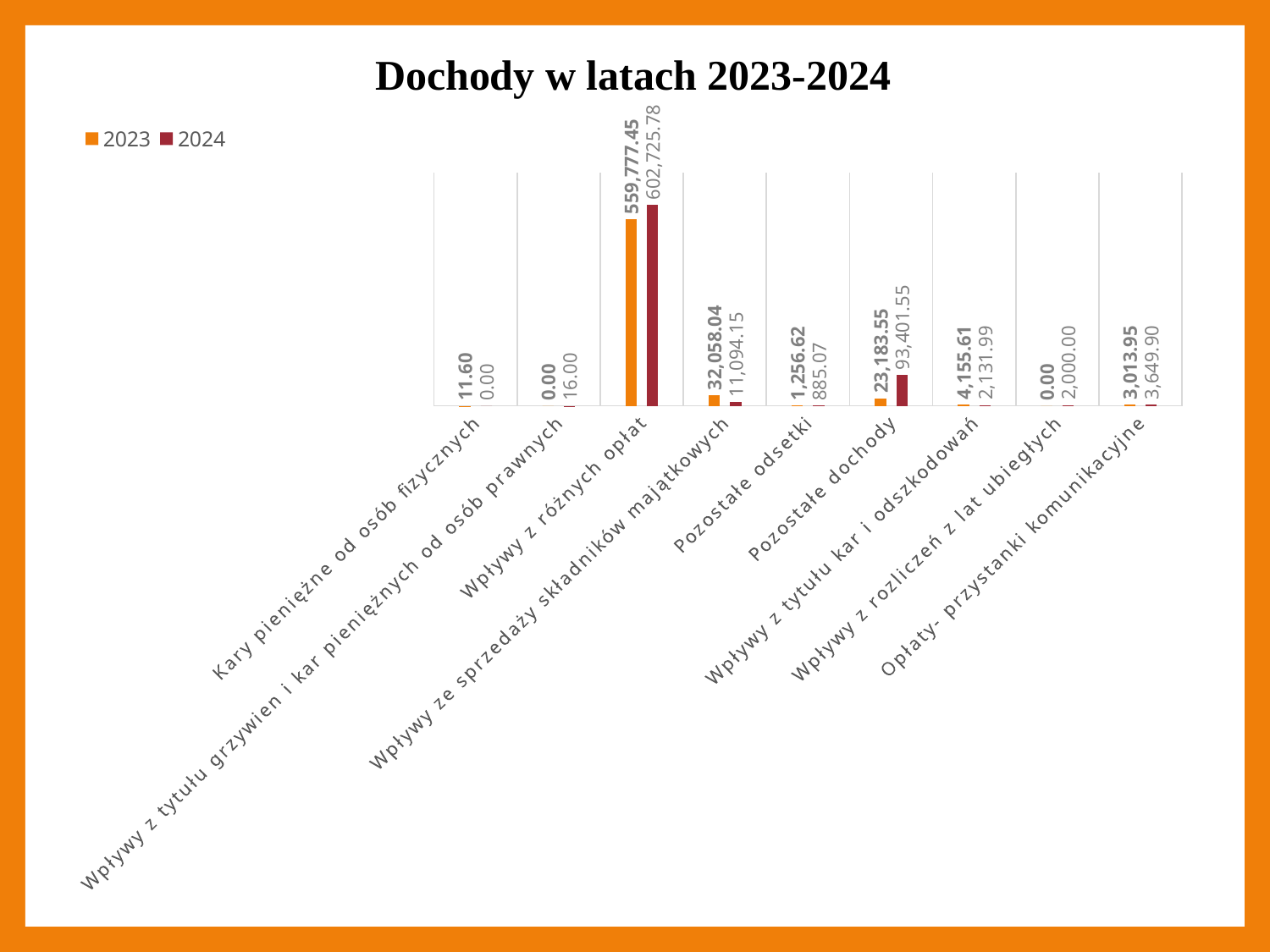
How many series does the legend list? 2 What is the difference between the 2024 and 2023 values for Wpływy z różnych opłat? 42,948.33 What is the 2024 value for Wpływy ze sprzedaży składników majątkowych? 11,094.15 Which is larger for Pozostałe odsetki, the 2023 value or the 2024 value? 2023 What is the 2023 value for Opłaty- przystanki komunikacyjne? 3,013.95 Which category has the highest 2024 value? Wpływy z różnych opłat What is the difference between the 2024 and 2023 values for Pozostałe dochody? 70,218.00 How many categories are shown on the x axis? 9 What is the 2023 value for Wpływy z różnych opłat? 559,777.45 What is the 2024 value for Pozostałe dochody? 93,401.55 What is the title of the chart? Dochody w latach 2023-2024 What kind of chart is shown on the slide? Bar chart